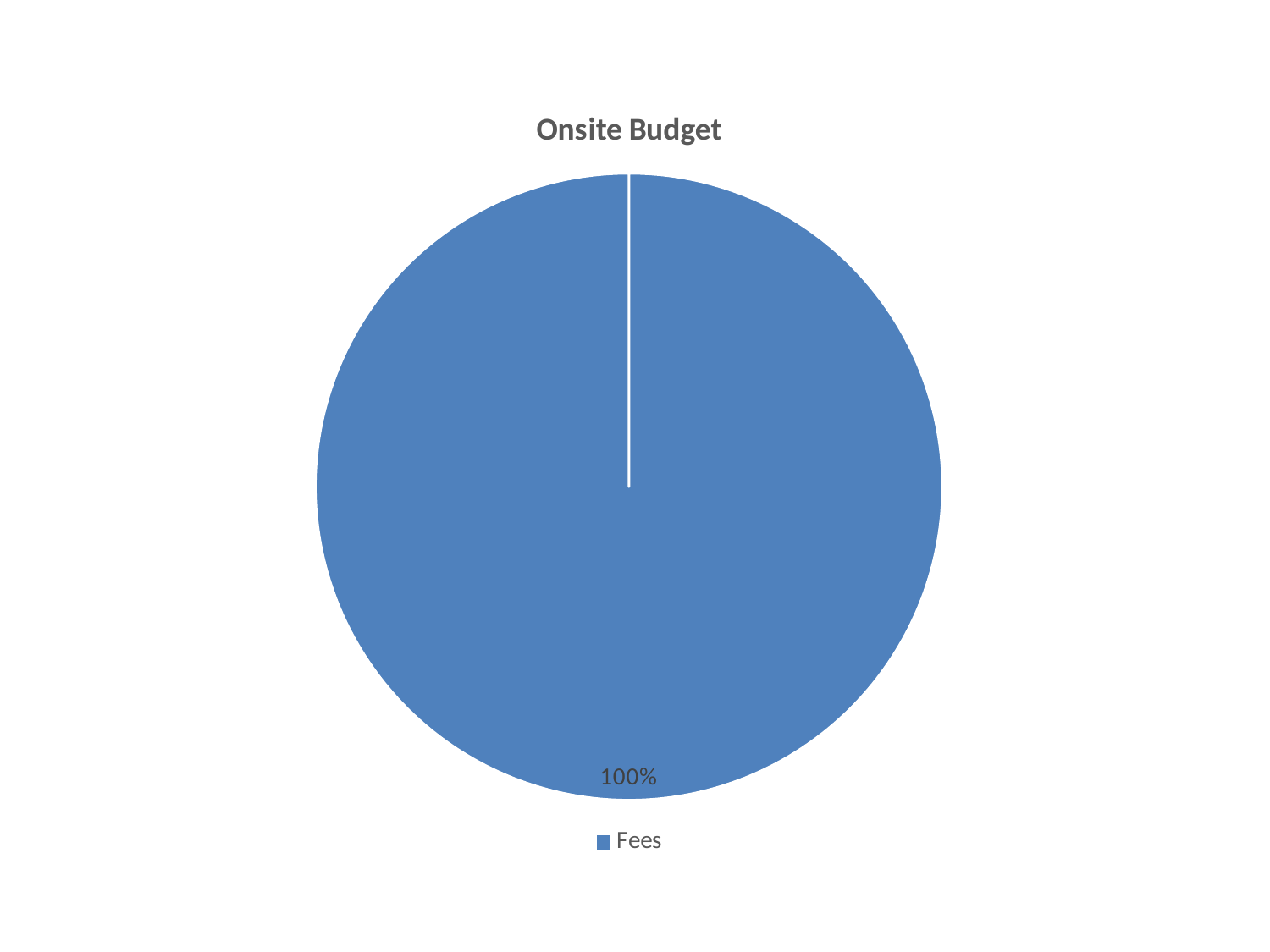
How many slices does the pie chart have? 1 What is the data label printed on the Fees slice? 100% How many entries does the legend list? 1 What is the title of the chart? Onsite Budget What share of the pie does the Fees slice represent? 100% What is the label of the only category in the legend? Fees What kind of chart is shown on the slide? pie chart Which category has the largest share of the pie? Fees